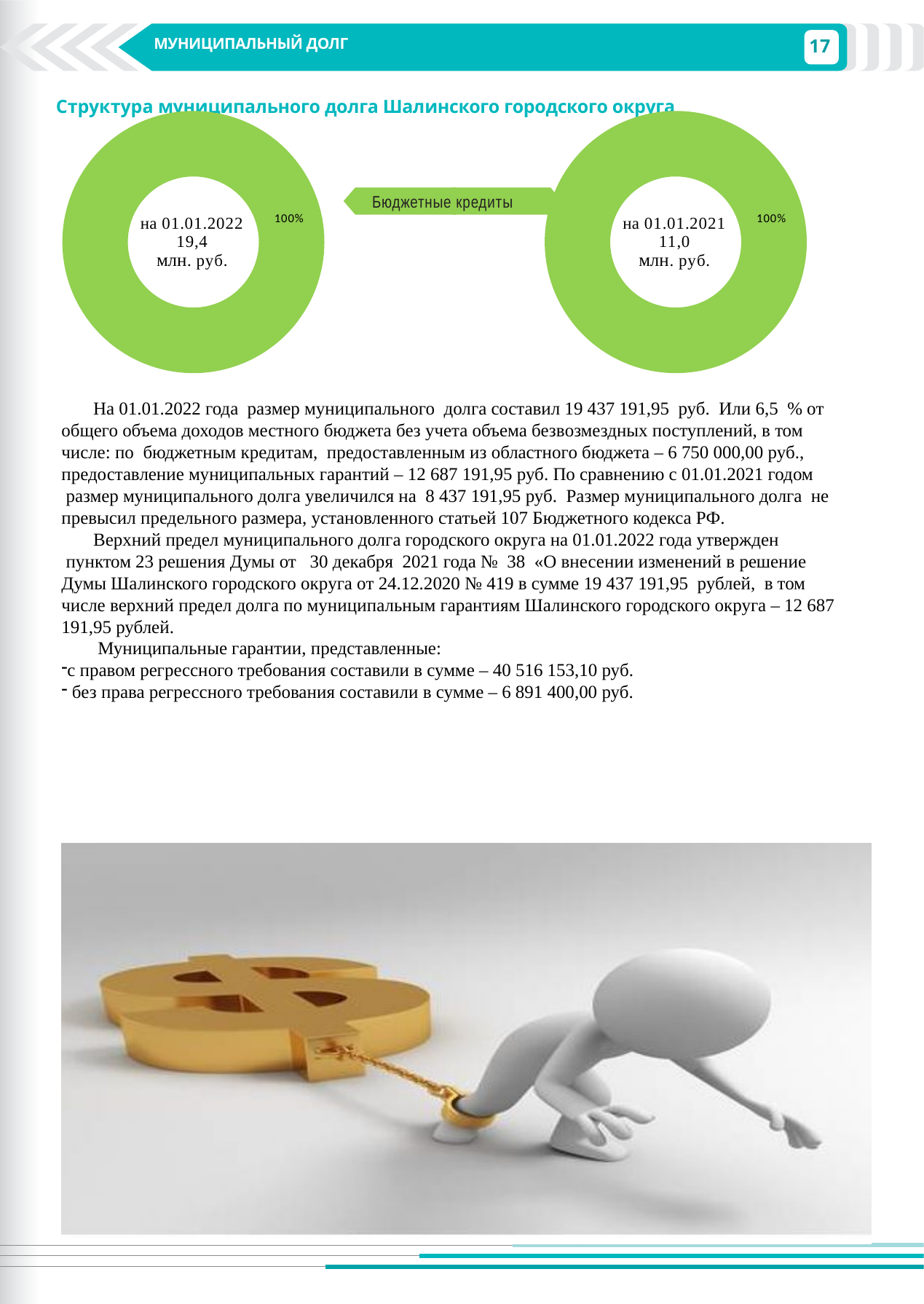
What total amount of municipal debt is shown in the centre of the left chart (на 01.01.2022)? 19,4 млн. руб. How many slices does the right chart (на 01.01.2021) contain? 1 What category label is shown between the two doughnut charts? Бюджетные кредиты What total amount of municipal debt is shown in the centre of the right chart (на 01.01.2021)? 11,0 млн. руб. How many slices does the left chart (на 01.01.2022) contain? 1 What kind of chart is the right chart (на 01.01.2021)? Doughnut (pie) chart What kind of chart is the left chart (на 01.01.2022)? Doughnut (pie) chart By how many млн. руб. does the debt shown in the 01.01.2022 chart exceed the debt shown in the 01.01.2021 chart? 8,4 млн. руб. Which chart shows the larger total debt, the one for 01.01.2022 or the one for 01.01.2021? 01.01.2022 What colour are the slices in both doughnut charts? Green In the left chart (на 01.01.2022), what share of the doughnut does the single slice take? 100% In the right chart (на 01.01.2021), what share of the doughnut does the single slice take? 100%